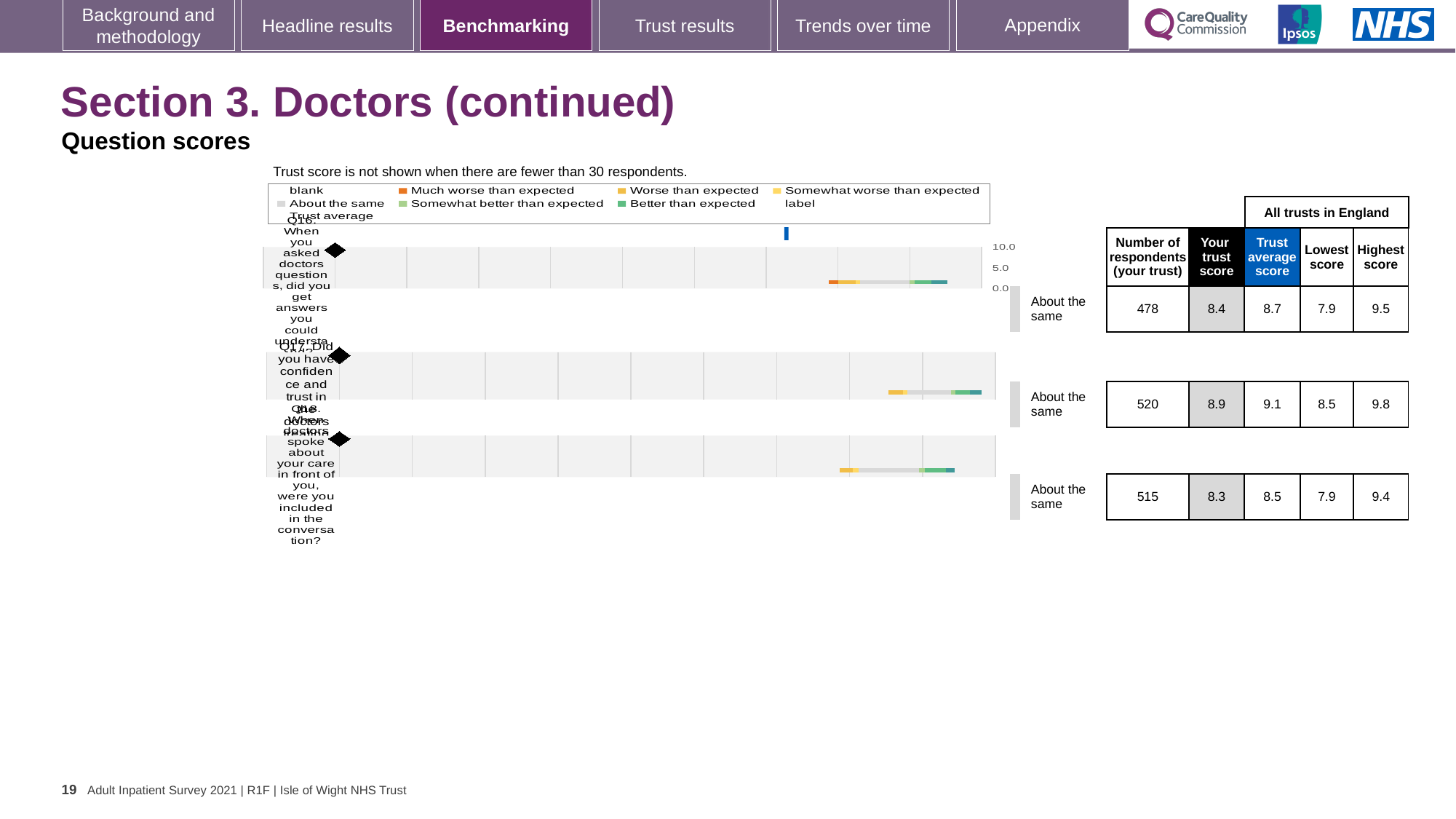
How many questions are shown in the benchmarking chart on this slide? 3 What benchmark category is shown next to each of the three questions on this slide? About the same What is the trust average score for Q18 (When doctors spoke about your care in front of you, were you included in the conversation)? 8.5 Which question has the lowest 'Your trust score' on this slide? Q18 What is the difference between the trust average score and your trust score for Q16? 0.3 What is your trust score for Q17 (Did you have confidence and trust in the doctors treating you)? 8.9 What is the highest score across all trusts in England for Q17? 9.8 What is the lowest score across all trusts in England for Q16? 7.9 Is your trust score for Q17 higher or lower than the trust average score for Q17? lower Which question has the highest 'Your trust score' on this slide? Q17 What kind of chart is used to show the question scores on this slide? bar chart How many respondents from your trust answered Q16 (When you asked doctors questions, did you get answers you could understand)? 478